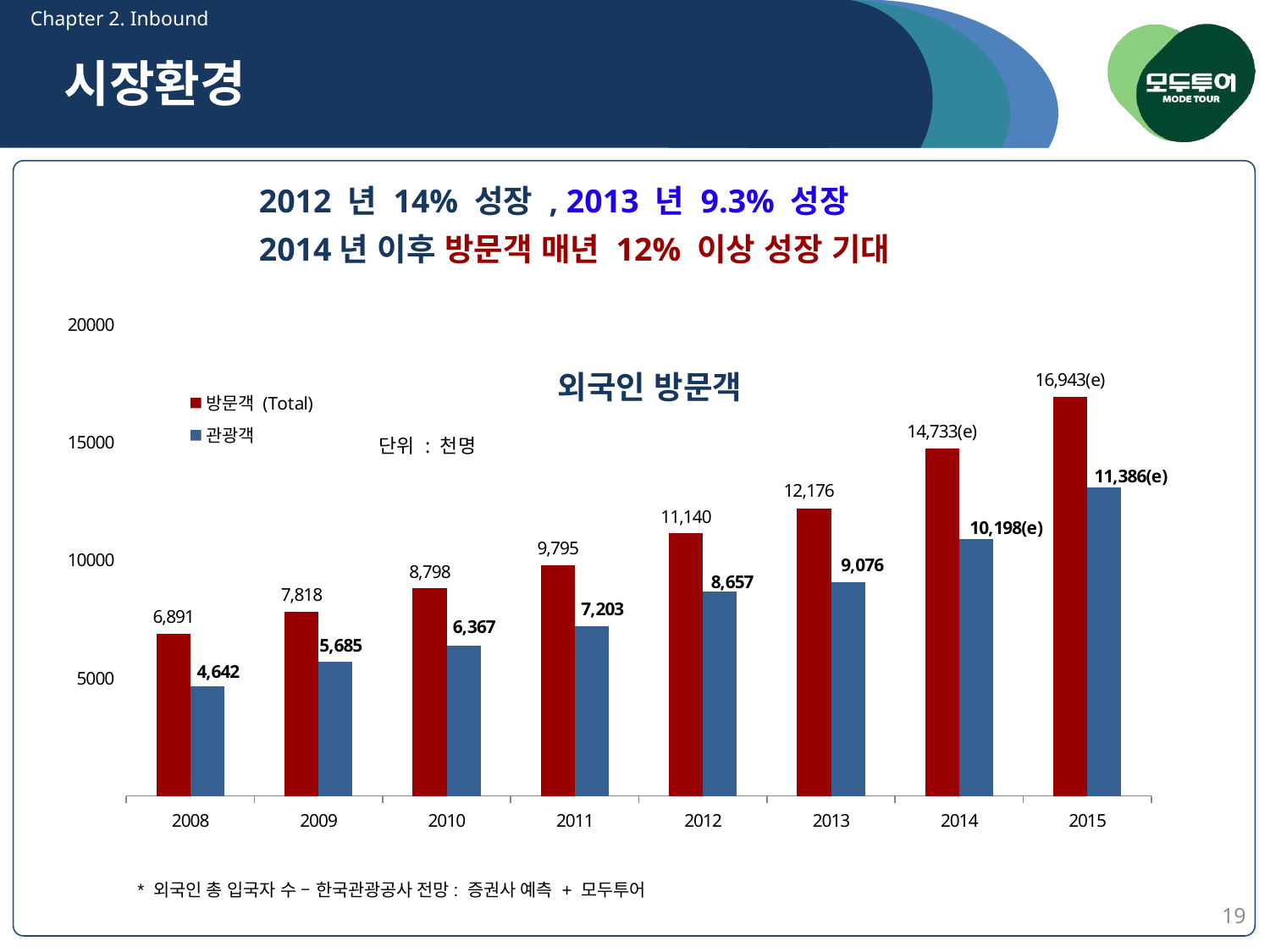
How many years are shown on the x axis? 8 Do the values of 방문객 (Total) rise or fall from 2008 to 2015? rise What is the difference between 방문객 (Total) and 관광객 in 2013? 3,100 Which is larger in 2011: 방문객 (Total) or 관광객? 방문객 (Total) What kind of chart is shown on the slide? bar chart What is the value of 관광객 for 2012? 8,657 Which year has the lowest value for 관광객? 2008 What is the value of 방문객 (Total) for 2010? 8,798 Which year has the highest value for 방문객 (Total)? 2015 Is the value of 관광객 for 2014 greater or less than 10000? greater How many series does the legend list? 2 What is the value of 방문객 (Total) for 2015? 16,943(e)